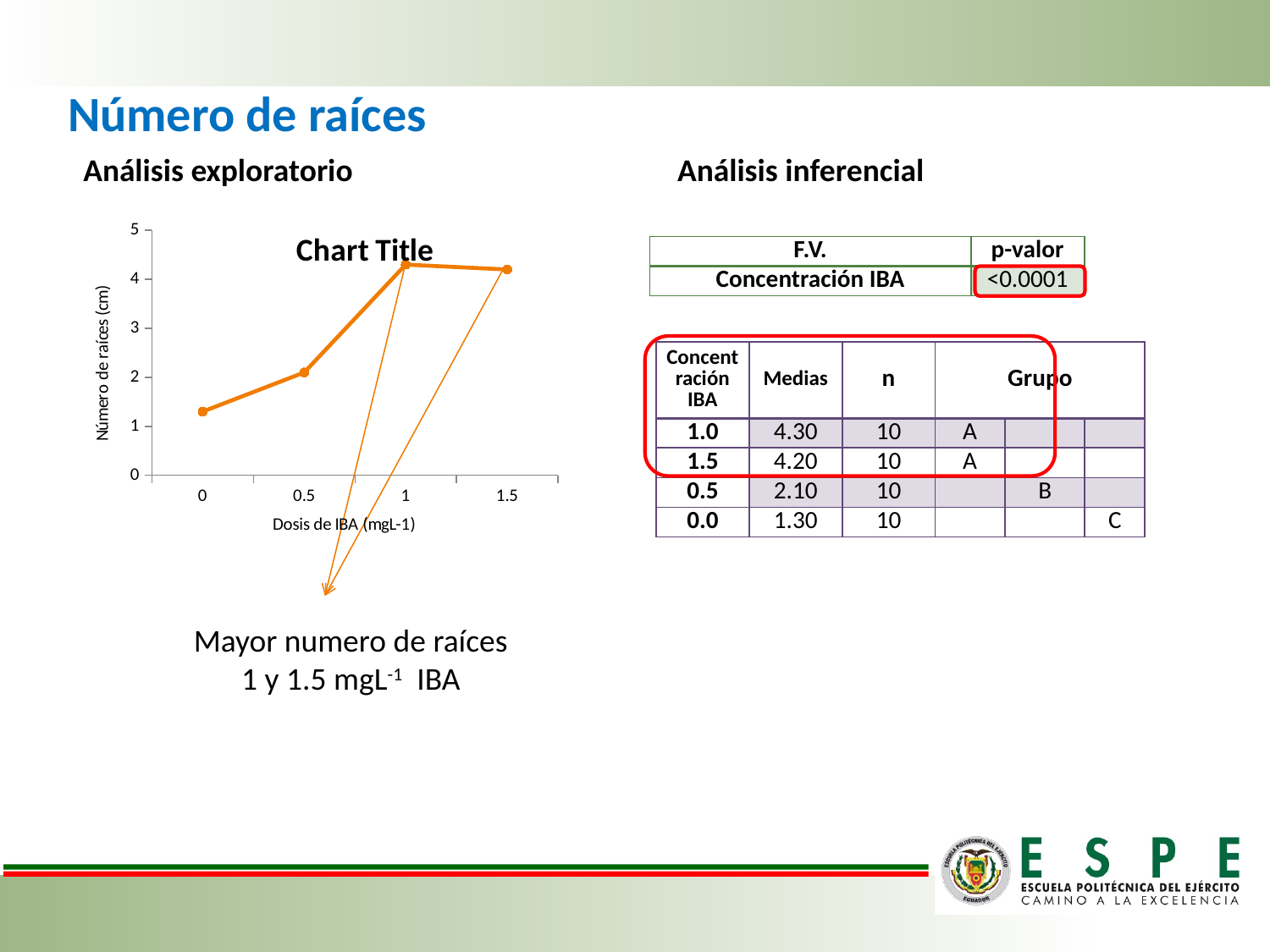
How many data points are plotted on the line chart? 4 On the line chart, is the value at dose 0 greater or less than 2? less On the line chart, which dose has the larger value, 0.5 or 1? 1 What is the x-axis label of the line chart? Dosis de IBA (mgL-1) On the line chart, is the value at dose 1 greater or less than 4? greater On the line chart, is the value at dose 0.5 greater or less than 3? less What kind of chart is shown under "Análisis exploratorio"? line chart What is the title printed on the line chart? Chart Title Which dose on the x axis of the line chart has the lowest number of roots? 0 On the line chart, do the values rise or fall from dose 0 to dose 1? rise On the line chart, which dose has the larger value, 0 or 0.5? 0.5